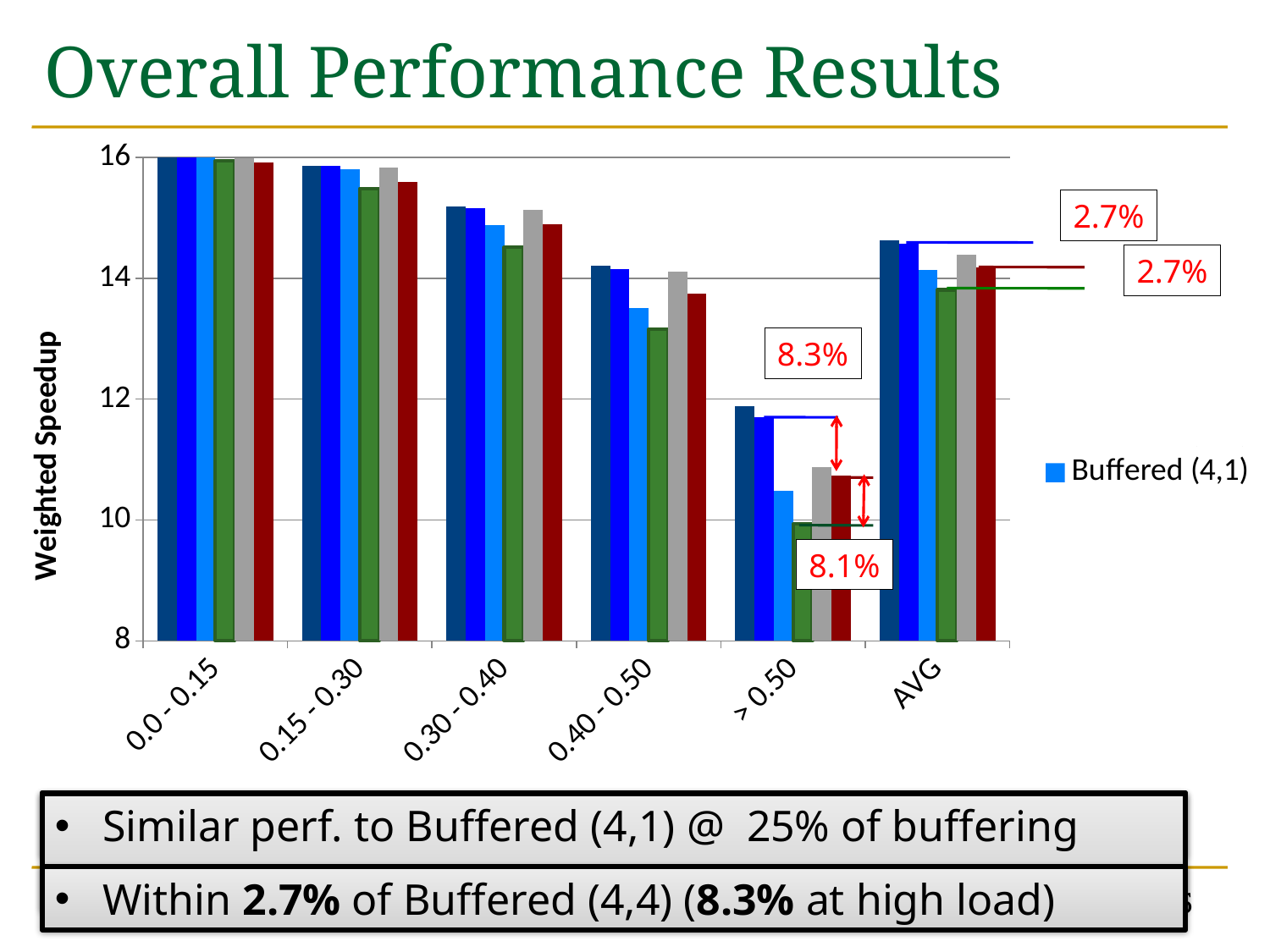
Is the Buffered (4,1) value for the 0.40 - 0.50 category greater or less than 14? less Is the Buffered (4,1) value for the > 0.50 category greater or less than 12? less What percentage is annotated above the > 0.50 category group in the chart? 8.3% In which category does the Buffered (4,1) series have its lowest value? > 0.50 Which series name is readable in the chart's legend? Buffered (4,1) Is the Buffered (4,1) value larger for 0.0 - 0.15 or for > 0.50? 0.0 - 0.15 How many bars are plotted in each category group of the chart? 6 Is the Buffered (4,1) value for the 0.0 - 0.15 category greater or less than 14? greater How many categories are shown on the x axis of the chart? 6 What is the label of the y axis of the chart? Weighted Speedup What kind of chart is shown on the slide? bar chart Do the weighted speedup values rise or fall from the 0.0 - 0.15 category to the > 0.50 category? fall